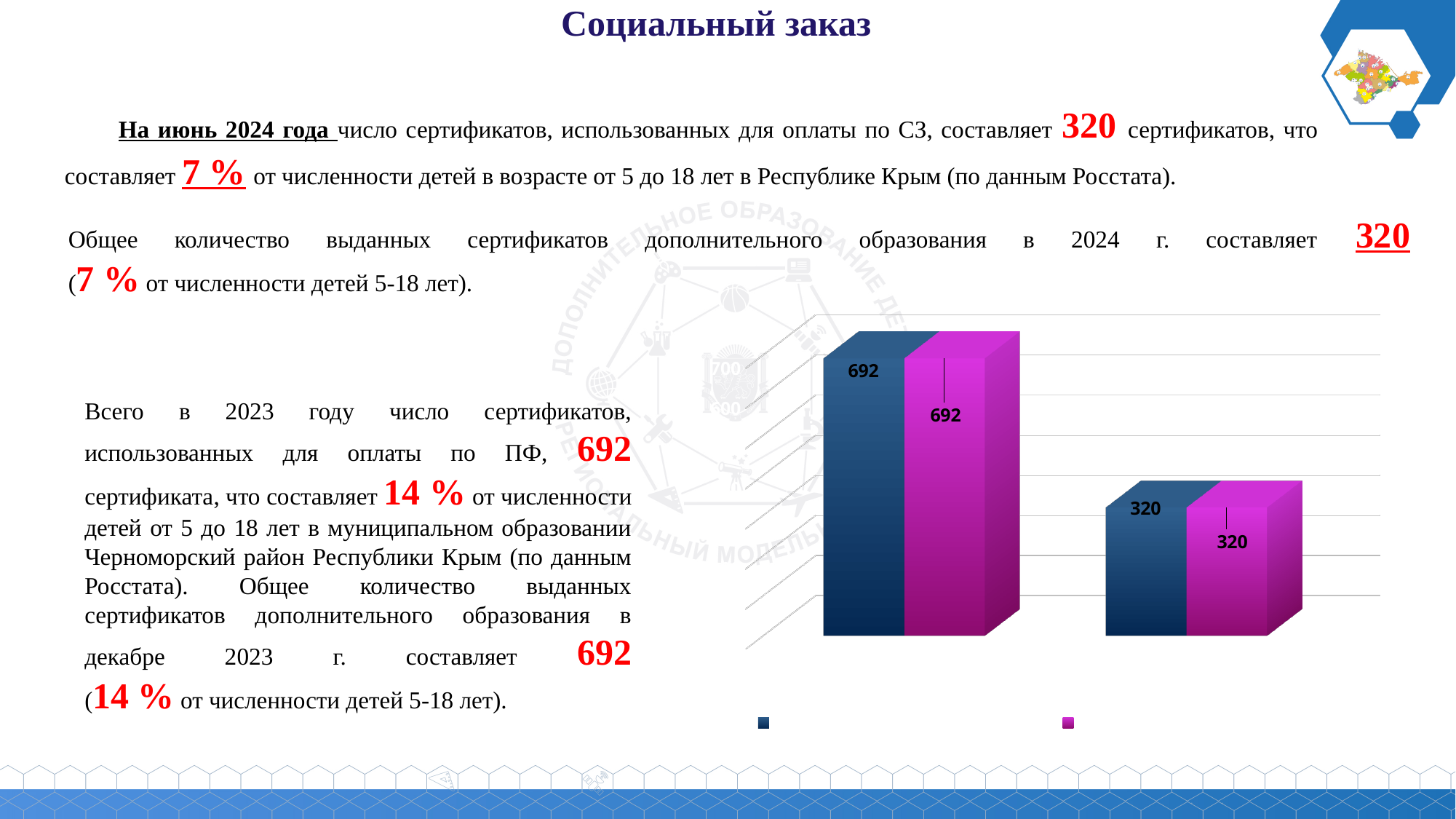
What value is labelled on the magenta bar in the right group of the chart? 320 How many series does the chart's legend show? 2 What is the highest value labelled on any bar in the chart? 692 What value is labelled on the magenta bar in the left group of the chart? 692 What value is labelled on the dark blue bar in the right group of the chart? 320 Which group of bars in the chart has the higher values, the left group or the right group? the left group Do the bar values rise or fall from the left group to the right group of the chart? fall What kind of chart is shown on the slide? bar chart What is the difference between the dark blue bar in the left group and the dark blue bar in the right group? 372 What two colours are used for the bars in the chart? dark blue and magenta What value is labelled on the dark blue bar in the left group of the chart? 692 How many groups of bars are plotted in the chart? 2